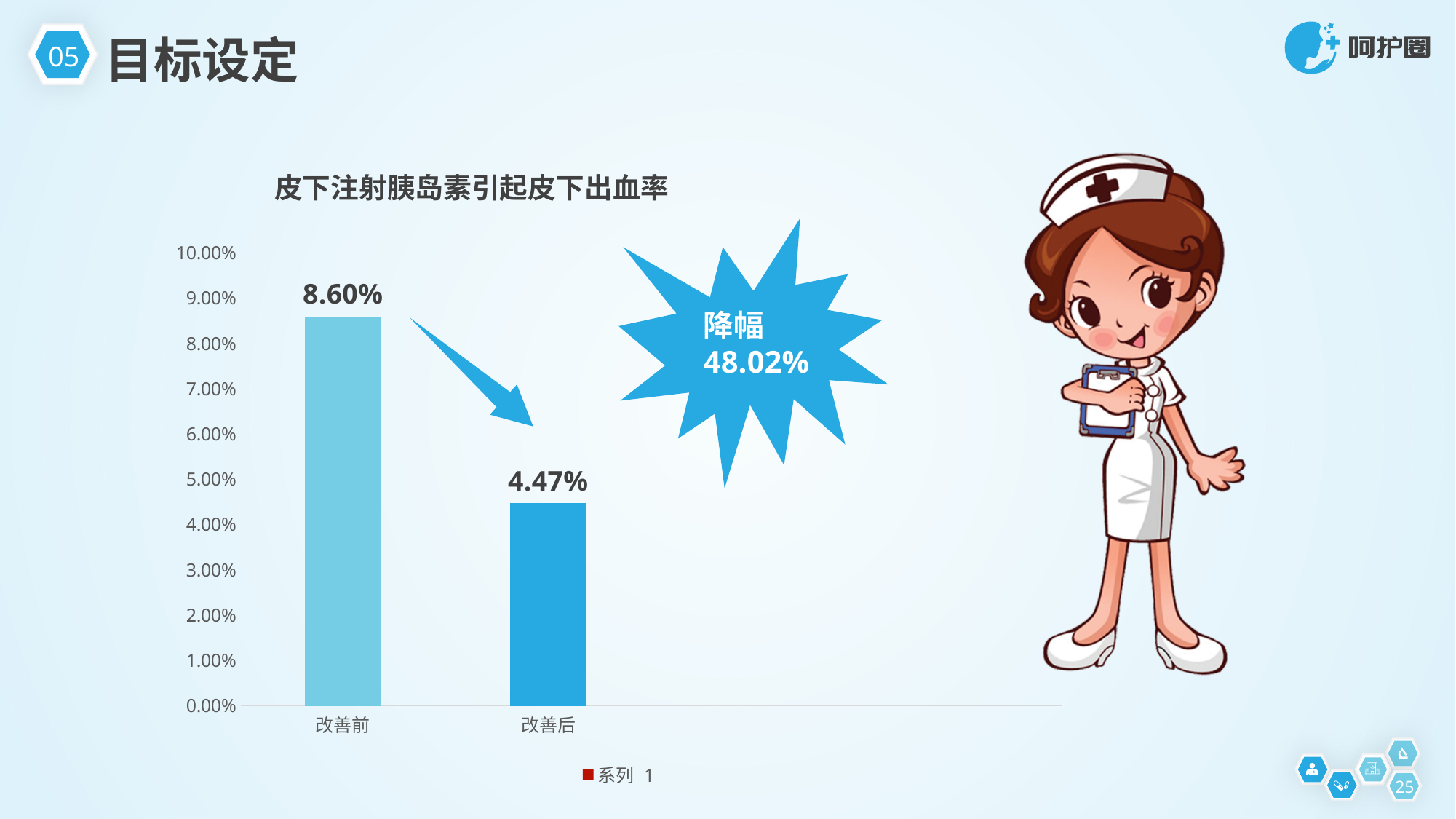
How many categories are shown on the x axis? 2 What is the value for 改善前? 8.60% What is the difference between the values for 改善前 and 改善后? 4.13% Which category has the highest value? 改善前 What kind of chart is shown? bar chart Which is larger, the value for 改善前 or 改善后? 改善前 Do the values rise or fall from 改善前 to 改善后? fall Is the value for 改善前 greater or less than 8.00%? greater What is the title of the chart? 皮下注射胰岛素引起皮下出血率 What is the value for 改善后? 4.47% Which category has the lowest value? 改善后 Is the value for 改善后 greater or less than 5.00%? less